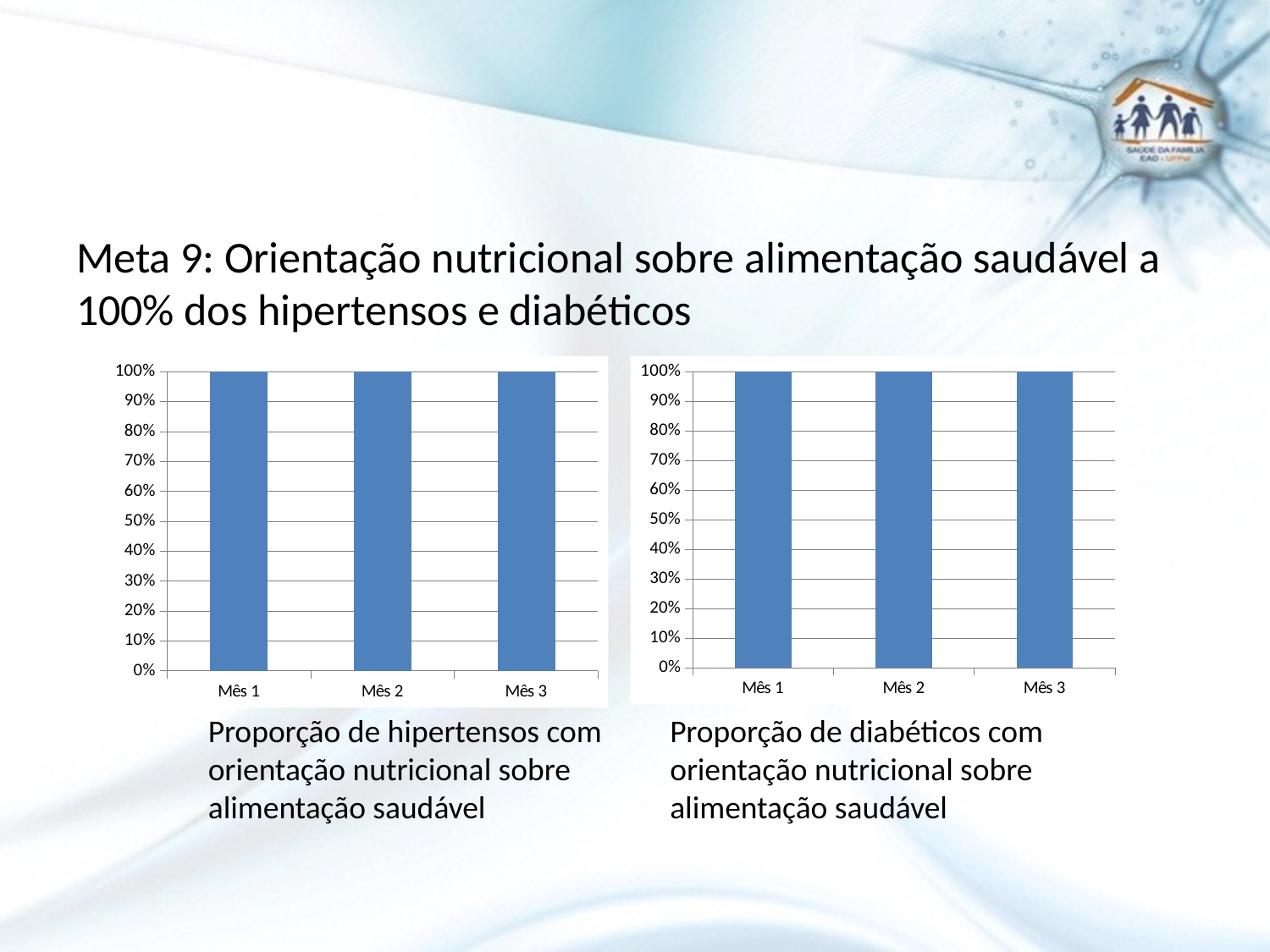
What kind of chart is the right chart (Proporção de diabéticos com orientação nutricional sobre alimentação saudável)? Bar chart In the right chart (Proporção de diabéticos com orientação nutricional sobre alimentação saudável), what is the value for Mês 2? 100% In the left chart (Proporção de hipertensos com orientação nutricional sobre alimentação saudável), do the values rise, fall or stay the same from Mês 1 to Mês 3? Stay the same How many bars are plotted in the right chart (Proporção de diabéticos com orientação nutricional sobre alimentação saudável)? 3 How many categories are shown on the x axis of the left chart (Proporção de hipertensos com orientação nutricional sobre alimentação saudável)? 3 In the right chart (Proporção de diabéticos com orientação nutricional sobre alimentação saudável), what is the value for Mês 3? 100% What kind of chart is the left chart (Proporção de hipertensos com orientação nutricional sobre alimentação saudável)? Bar chart What is the highest value shown on the y axis of the left chart (Proporção de hipertensos com orientação nutricional sobre alimentação saudável)? 100% In the left chart (Proporção de hipertensos com orientação nutricional sobre alimentação saudável), what is the value for Mês 3? 100% In the right chart (Proporção de diabéticos com orientação nutricional sobre alimentação saudável), what is the difference between the values for Mês 1 and Mês 3? 0% In the left chart (Proporção de hipertensos com orientação nutricional sobre alimentação saudável), what is the value for Mês 1? 100% In the right chart (Proporção de diabéticos com orientação nutricional sobre alimentação saudável), do the values rise, fall or stay the same from Mês 1 to Mês 3? Stay the same